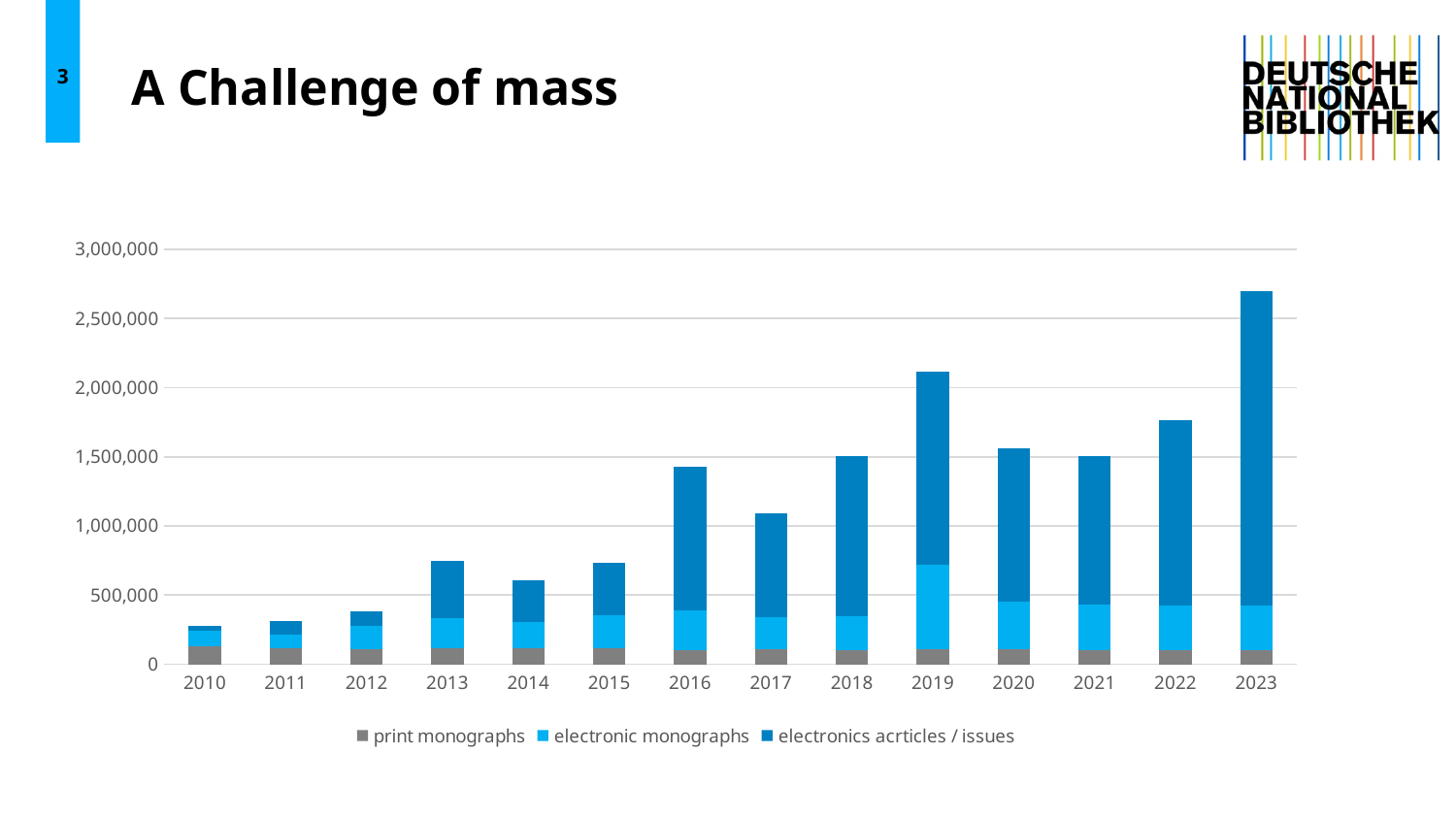
Is the total for 2016 greater or less than 1,000,000? greater Which series is shown in grey at the bottom of each bar? print monographs Which year has the taller stacked bar, 2019 or 2022? 2019 Which year has the shortest stacked bar? 2010 Which year has the tallest stacked bar? 2023 How many years are shown on the x axis of the chart? 14 Is the total for 2010 greater or less than 500,000? less Is the total for 2013 greater or less than 1,000,000? less What kind of chart is shown on the slide? stacked bar chart How many series does the chart's legend list? 3 Do the stacked bar totals generally rise or fall from 2010 to 2023? rise